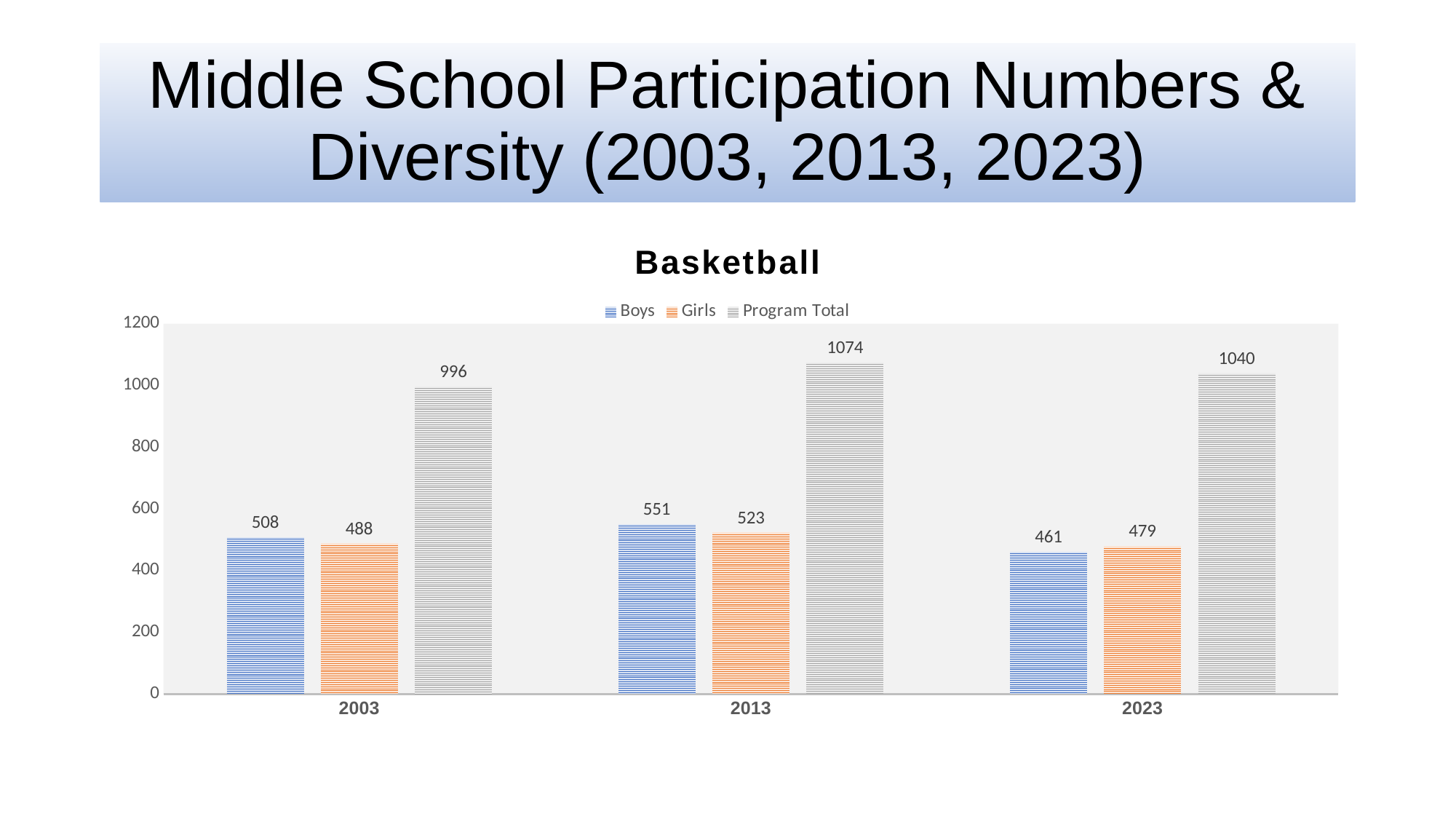
In which year is the Program Total highest? 2013 What is the difference between the Boys and Girls values in 2013? 28 What is the value for Boys in 2003? 508 Which is larger in 2023, the Boys value or the Girls value? Girls How many series does the legend list? 3 What is the Program Total for 2023? 1040 In which year is the Boys value lowest? 2023 What is the value for Girls in 2013? 523 What kind of chart is shown? bar chart How many years are shown on the x axis? 3 Is the Program Total for 2003 greater or less than 1000? less What is the title of the chart? Basketball